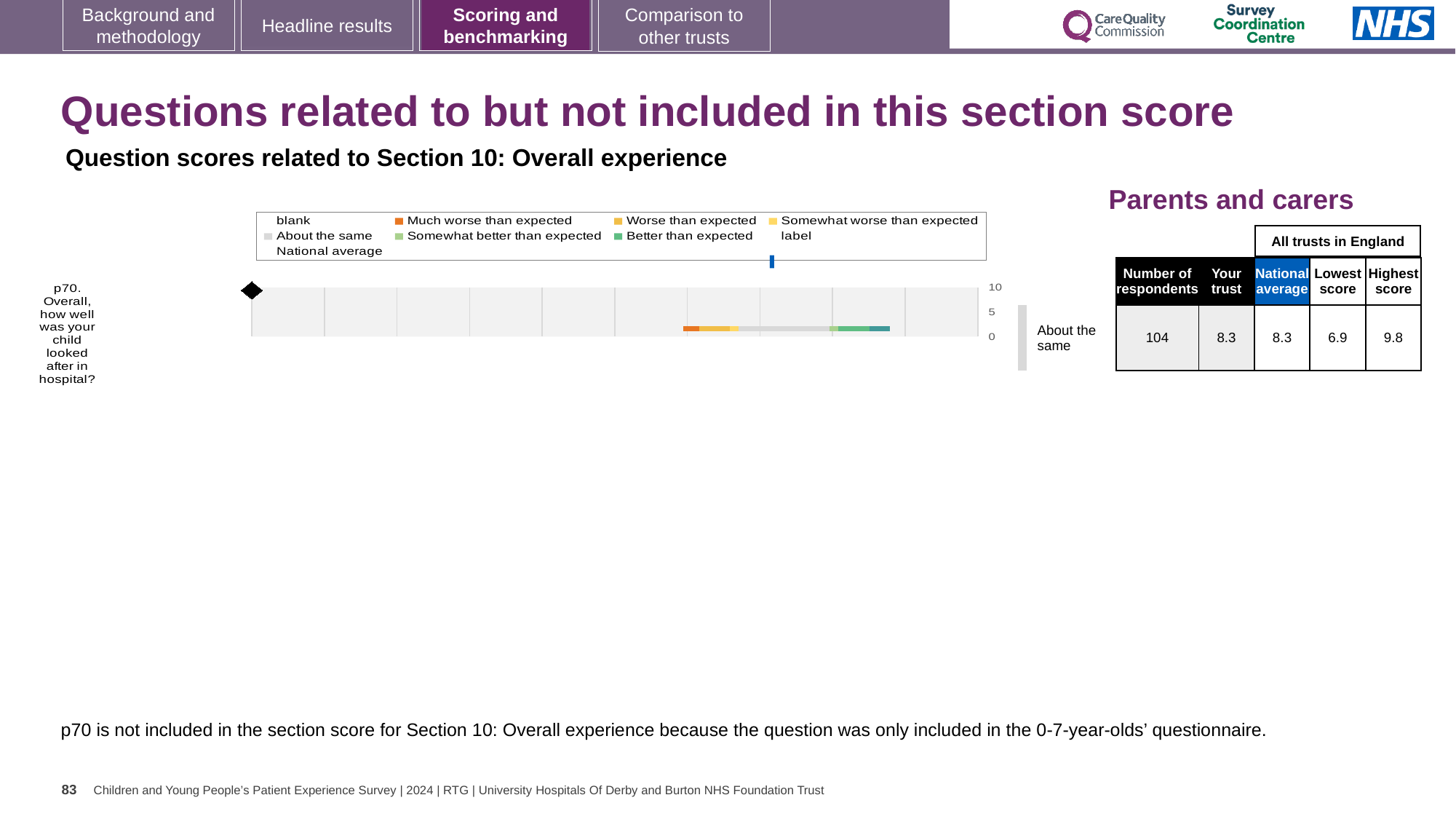
What benchmarking category is shown next to the bar for question p70? About the same Which question is plotted in the chart? p70. Overall, how well was your child looked after in hospital? How many respondents answered question p70? 104 What is the highest score among all trusts in England for question p70? 9.8 Which is larger for question p70: the 'Your trust' score or the lowest score among all trusts? Your trust What is the difference between the highest score and the lowest score for question p70? 2.9 How many survey questions are plotted in the chart? 1 What is the national average score for question p70? 8.3 What is the lowest score among all trusts in England for question p70? 6.9 What kind of chart is used to show the benchmarking result for question p70? Bar chart What is the maximum value shown on the chart's score axis? 10 What is the 'Your trust' score for question p70? 8.3